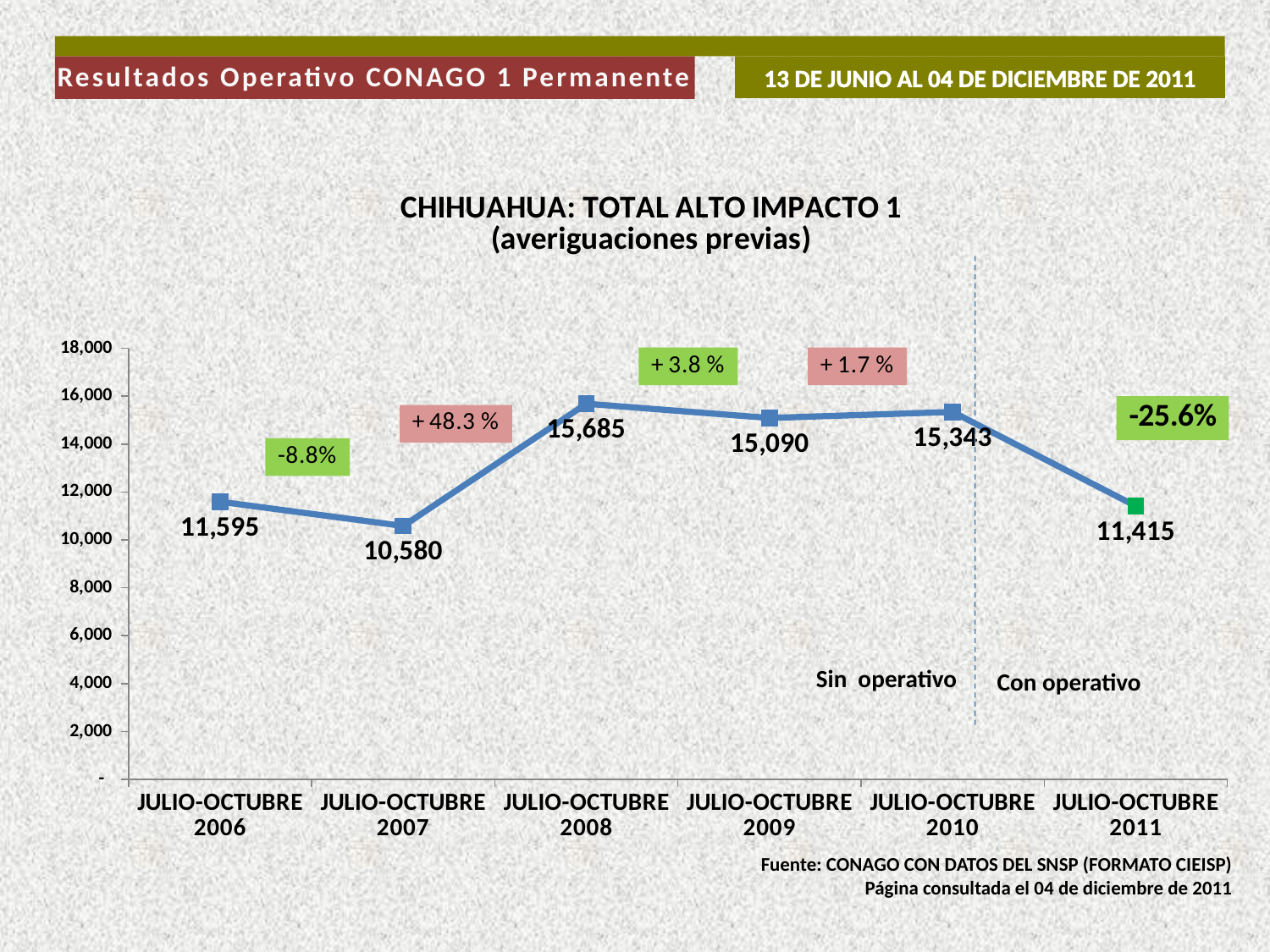
What is the value for JULIO-OCTUBRE 2006? 11,595 What kind of chart is shown? line chart What percentage change is labelled between JULIO-OCTUBRE 2007 and JULIO-OCTUBRE 2008? + 48.3 % What is the difference between the values for JULIO-OCTUBRE 2010 and JULIO-OCTUBRE 2011? 3,928 What is the value for JULIO-OCTUBRE 2008? 15,685 How many periods are plotted on the chart? 6 What is the value for JULIO-OCTUBRE 2011? 11,415 Does the value rise or fall from JULIO-OCTUBRE 2010 to JULIO-OCTUBRE 2011? fall Which is larger, the value for JULIO-OCTUBRE 2009 or JULIO-OCTUBRE 2010? JULIO-OCTUBRE 2010 Which period has the highest value? JULIO-OCTUBRE 2008 Is the value for JULIO-OCTUBRE 2007 greater or less than 12,000? less Which period has the lowest value? JULIO-OCTUBRE 2007